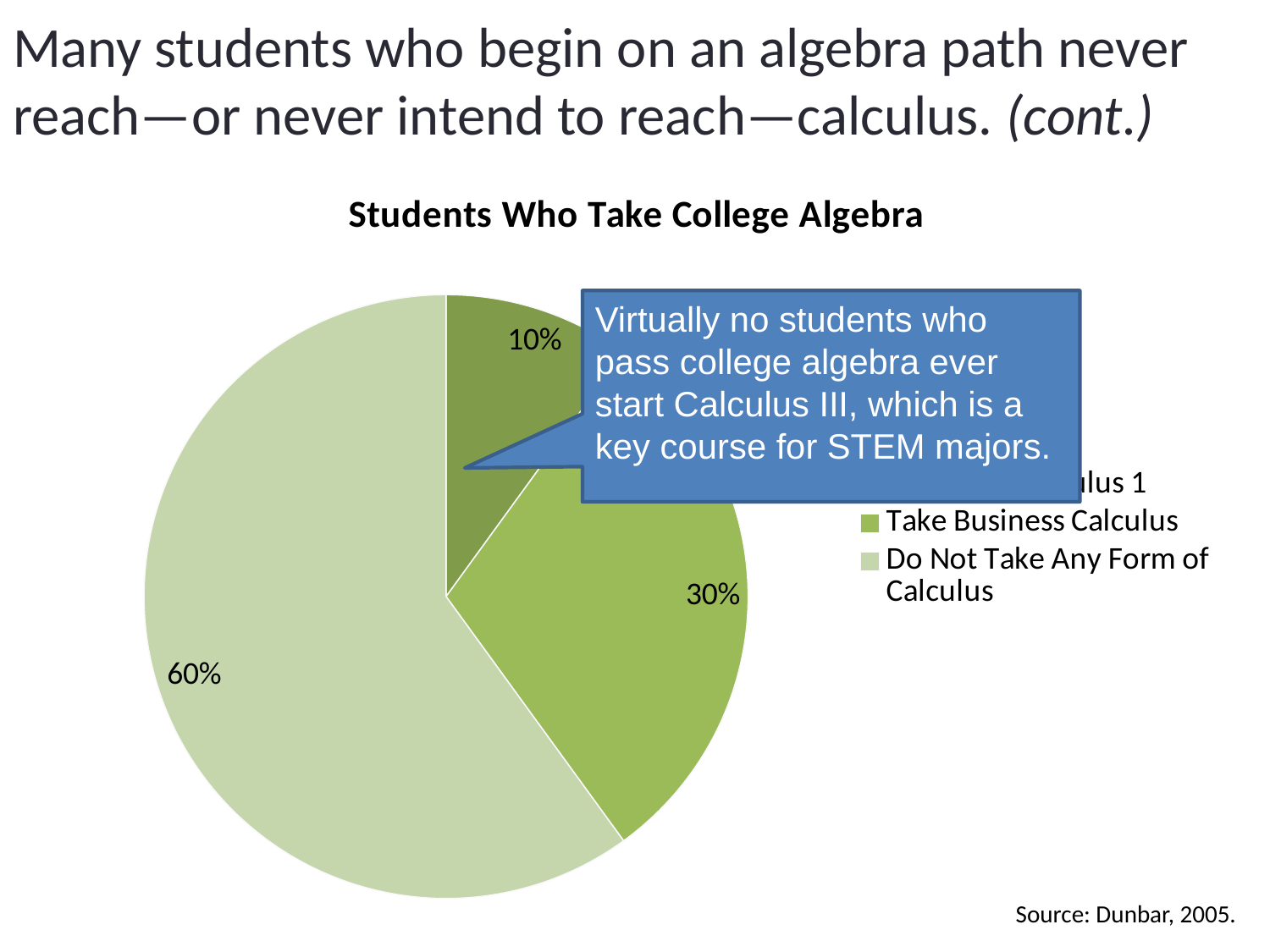
What kind of chart is shown on the slide? Pie chart What percentage of students who take college algebra take Business Calculus? 30% What percentage of students who take college algebra do not take any form of calculus? 60% Which category has the largest slice of the pie? Do Not Take Any Form of Calculus What is the difference in percentage points between the Do Not Take Any Form of Calculus slice and the Take Business Calculus slice? 30 percentage points Which is larger: the Take Business Calculus slice or the Do Not Take Any Form of Calculus slice? Do Not Take Any Form of Calculus How many slices does the pie chart have? 3 What share of the pie does the Do Not Take Any Form of Calculus slice represent? 60% What do the three percentage labels on the pie chart add up to? 100% What is the smallest percentage shown on the pie chart? 10% What source is cited for the chart? Dunbar, 2005 What is the title of the pie chart? Students Who Take College Algebra